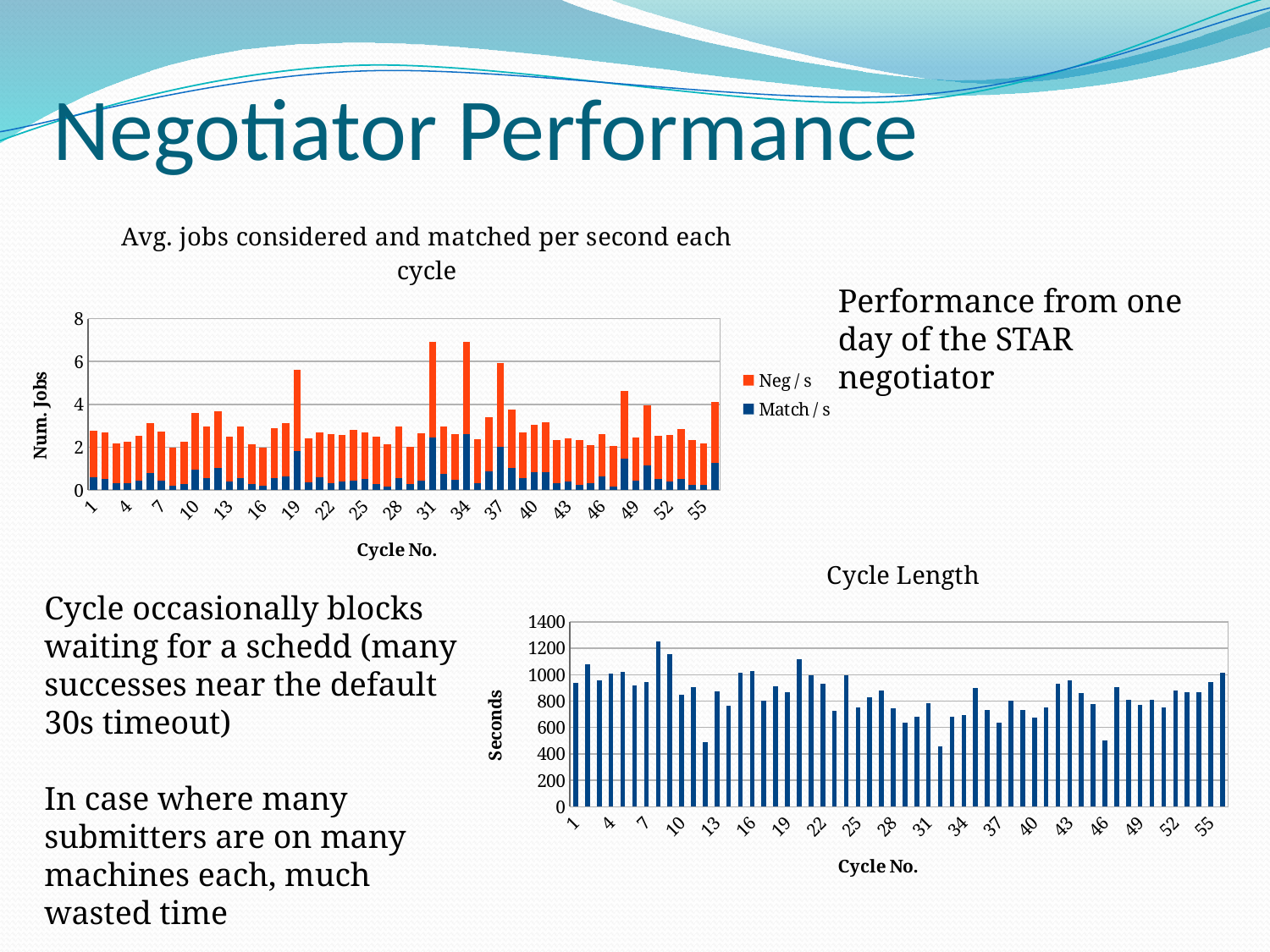
In the 'Cycle Length' chart, which cycle number has the highest value? 8 In the 'Avg. jobs considered and matched per second each cycle' chart, is the total stacked value for cycle 1 greater or less than 4? less In the 'Cycle Length' chart, which is larger, the value for cycle 8 or the value for cycle 33? cycle 8 In the 'Avg. jobs considered and matched per second each cycle' chart, what are the two series named in the legend? Neg / s and Match / s In the 'Cycle Length' chart, is the value for cycle 33 greater or less than 600? greater How many series does the legend of the 'Avg. jobs considered and matched per second each cycle' chart list? 2 In the 'Cycle Length' chart, is the value for cycle 19 greater or less than 1000? less What kind of chart is the 'Cycle Length' chart? bar chart What is the y-axis title of the 'Cycle Length' chart? Seconds